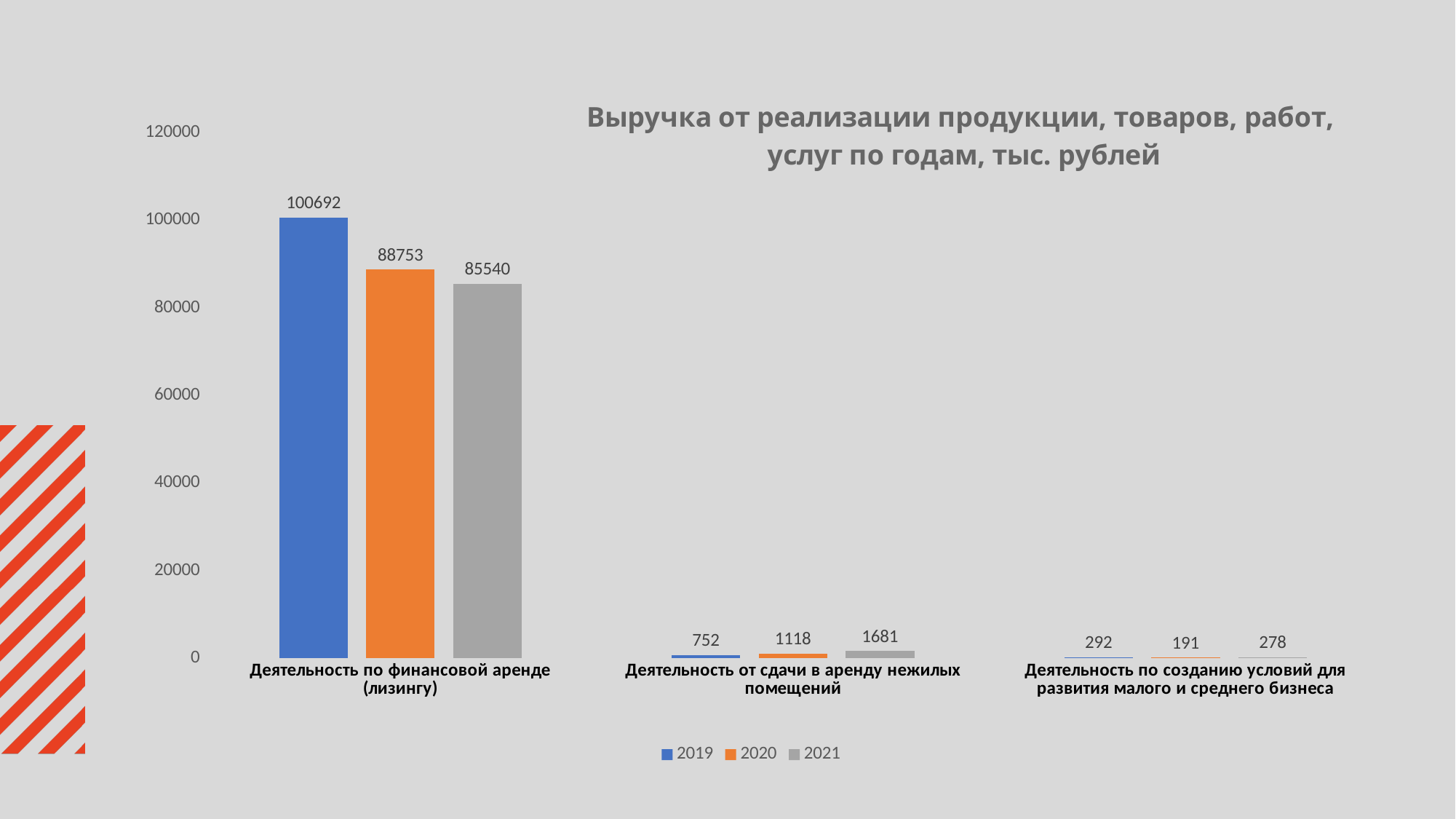
What is the 2019 value for Деятельность по финансовой аренде (лизингу)? 100692 How many categories are shown on the x axis? 3 What is the difference between the 2019 and 2021 values for Деятельность по финансовой аренде (лизингу)? 15152 Which category has the highest value in 2019? Деятельность по финансовой аренде (лизингу) Which is larger for Деятельность от сдачи в аренду нежилых помещений: the 2020 value or the 2021 value? 2021 Do the values for Деятельность по финансовой аренде (лизингу) rise or fall from 2019 to 2021? fall How many series does the legend list? 3 What is the 2020 value for Деятельность по созданию условий для развития малого и среднего бизнеса? 191 Which category has the lowest value in 2021? Деятельность по созданию условий для развития малого и среднего бизнеса What kind of chart is shown on the slide? bar chart What is the 2021 value for Деятельность от сдачи в аренду нежилых помещений? 1681 Is the 2020 value for Деятельность по финансовой аренде (лизингу) greater or less than 80000? greater